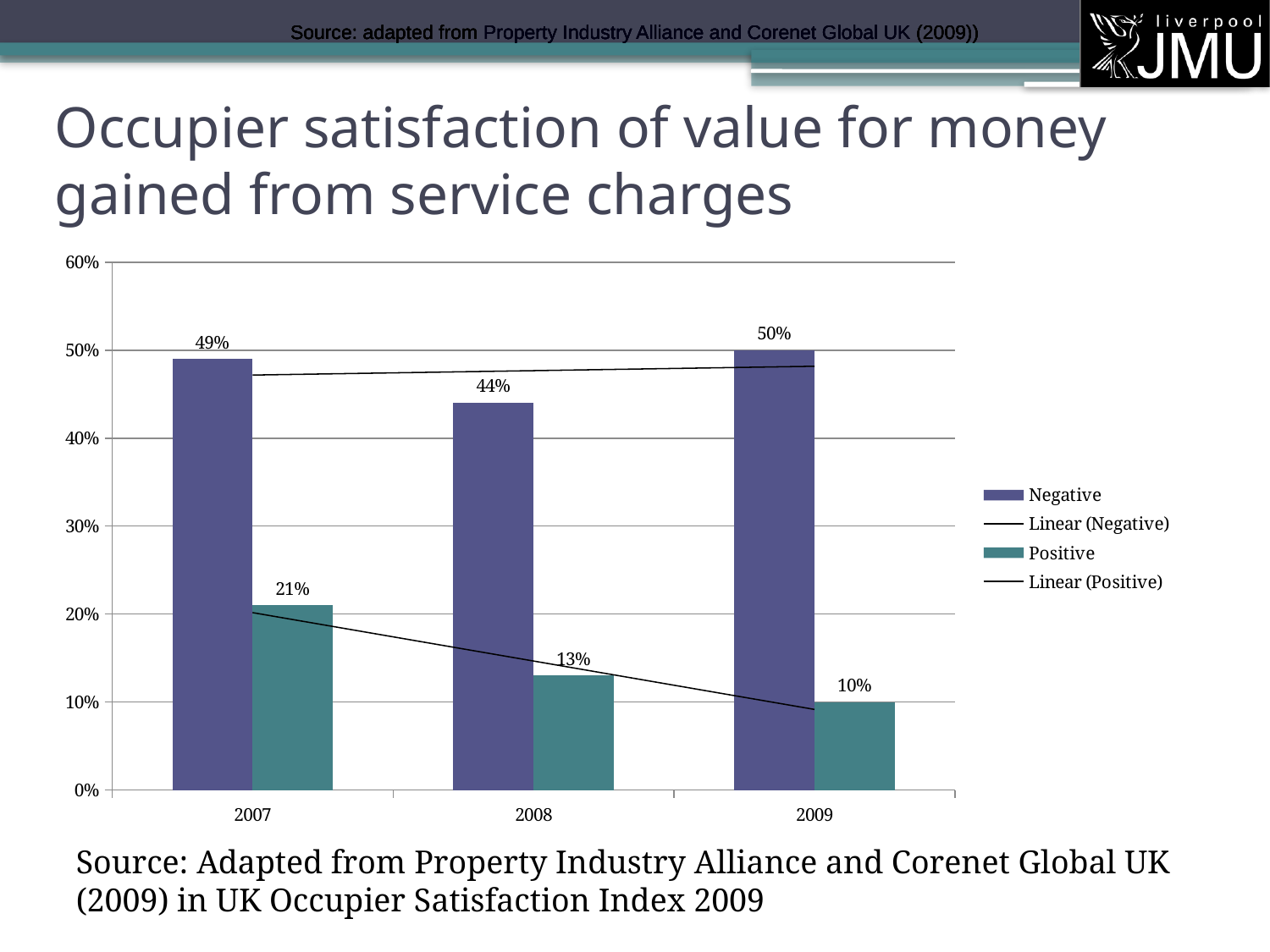
Is the Positive value for 2007 greater or less than 20%? greater Which year has the highest Negative value? 2009 What is the Negative value for 2007? 49% How many entries does the legend list? 4 Which is larger in 2008, the Negative value or the Positive value? Negative How many years are shown on the x axis? 3 Do the Positive values rise or fall from 2007 to 2009? Fall Which year has the lowest Positive value? 2009 What is the Positive value for 2009? 10% What kind of chart is shown on the slide? Bar chart What is the difference between the Negative and Positive values in 2007? 28% What is the Negative value for 2008? 44%